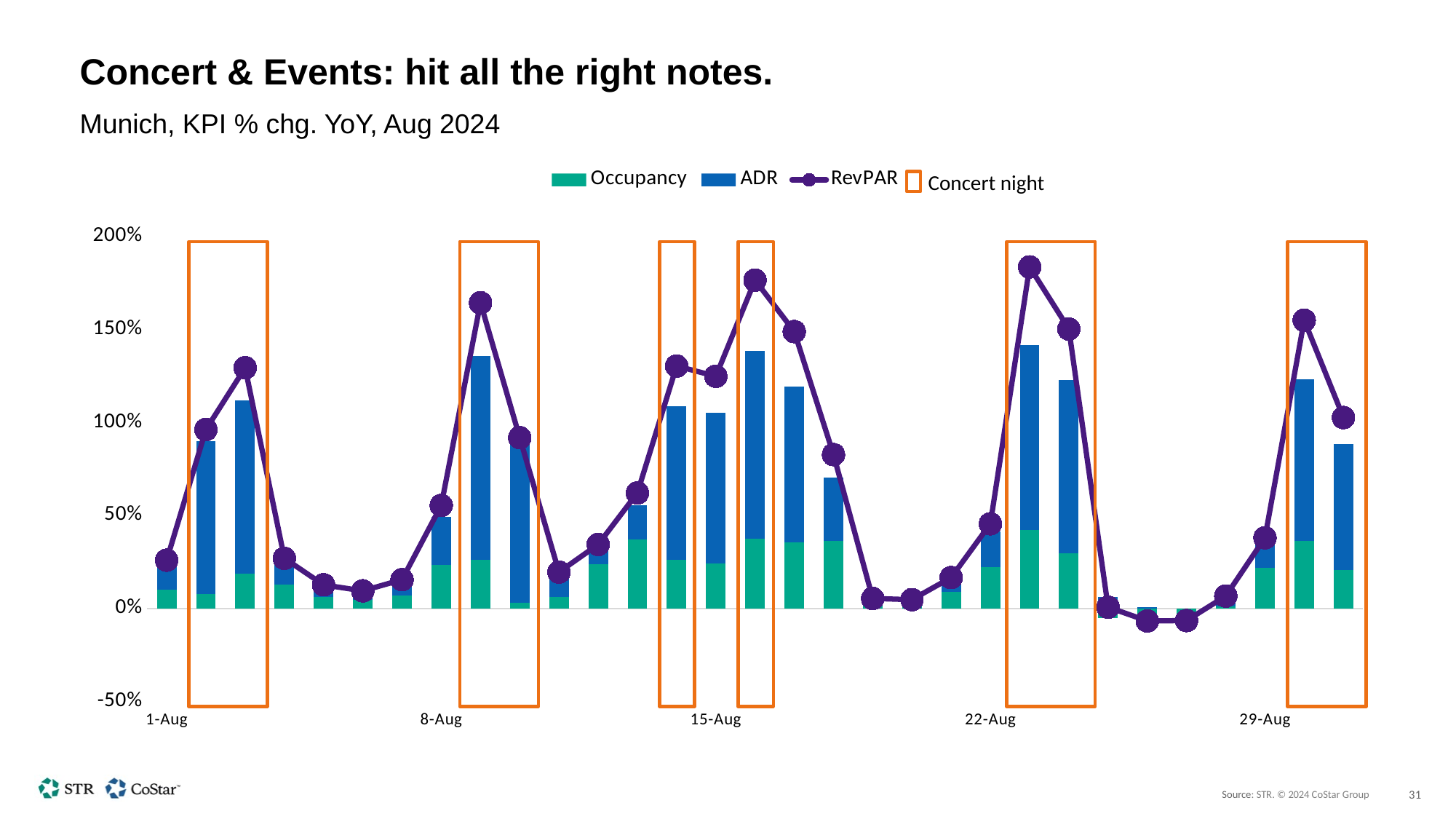
Does the RevPAR line rise or fall from 1-Aug to the following day? rise How many concert-night rectangles are drawn on the chart? 6 Which series is plotted as a line with markers? RevPAR What kind of chart is shown on the slide? A combined bar and line chart (stacked bars with a line) What do the orange rectangles on the chart mark? Concert night Is the RevPAR value for 15-Aug greater or less than 100%? greater Among the labelled dates 1-Aug, 8-Aug, 15-Aug, 22-Aug and 29-Aug, which has the highest RevPAR value? 15-Aug How many date labels are shown on the x axis? 5 Is the RevPAR value for 1-Aug greater or less than 50%? less How many entries does the chart legend list? 4 Is the RevPAR value for 8-Aug greater or less than 100%? less Which has the higher RevPAR value, 15-Aug or 8-Aug? 15-Aug